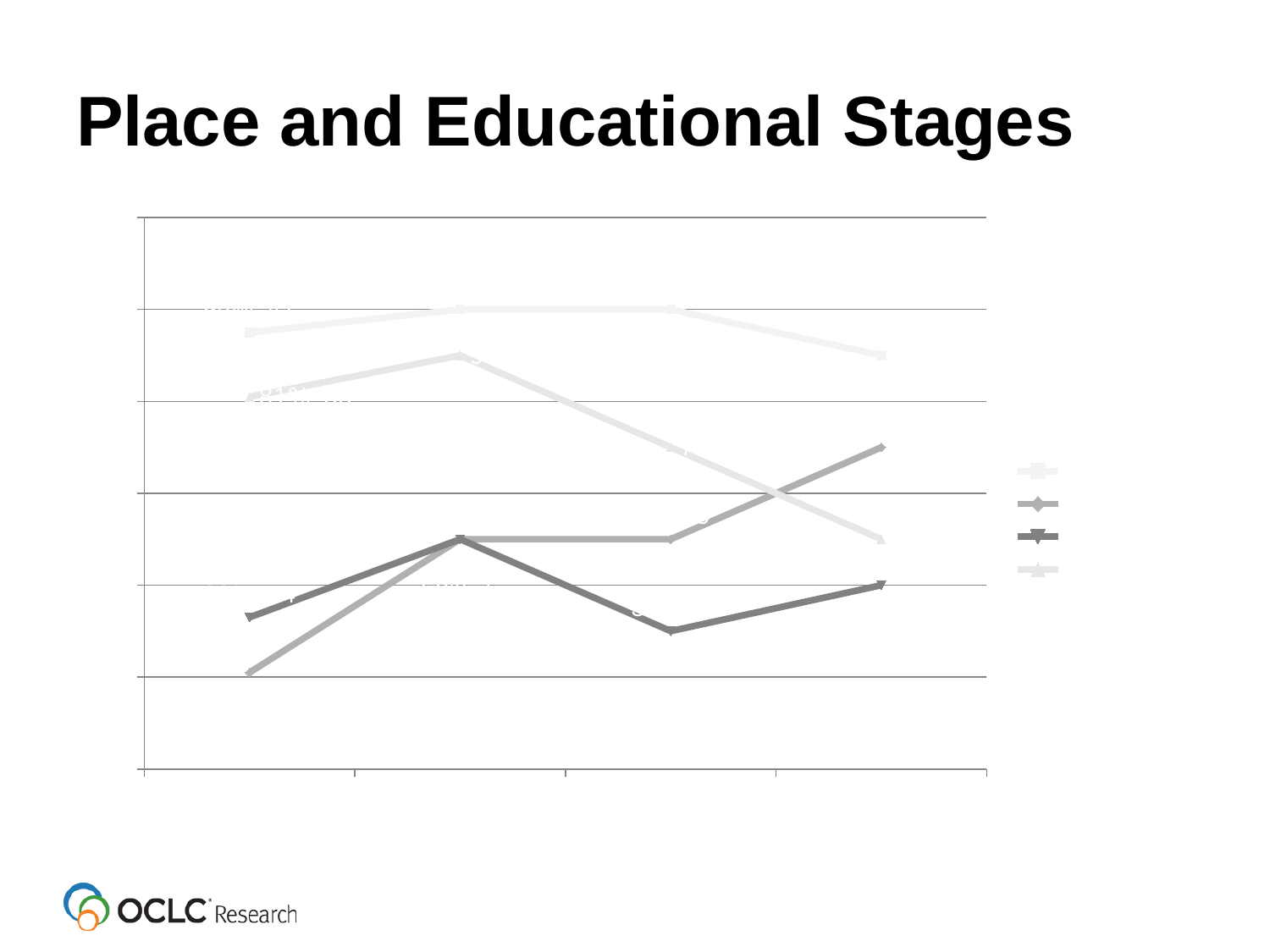
What kind of chart is shown on the slide? line chart Which line is highest at the first x-axis point: the lightest line or the darkest line? the lightest line How many data points does each line have along the x axis? 4 Which line is lowest at the last x-axis point? the darkest line How many series does the legend list? 4 What is the title of the slide containing the chart? Place and Educational Stages Does the lightest line end higher or lower than where it starts? lower Does the line with diamond markers end higher or lower than where it starts? higher